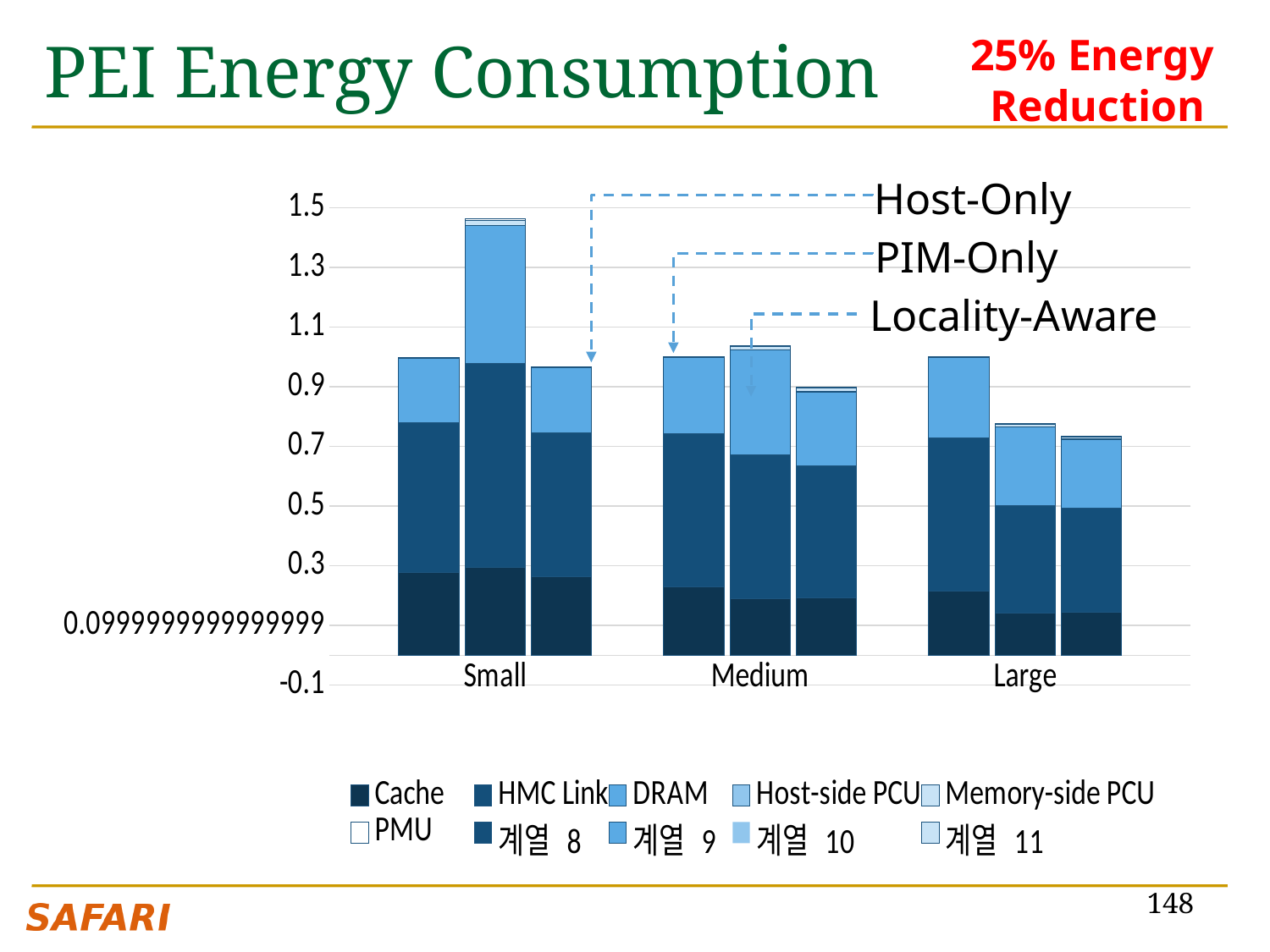
Is the PIM-Only bar for Small greater or less than 1.3? greater Is the PIM-Only bar for Large greater or less than 0.9? less Is the Locality-Aware bar for Large greater or less than 0.9? less What kind of chart is shown on the slide? stacked bar chart For Small, which bar is taller: PIM-Only or Locality-Aware? PIM-Only Do the Locality-Aware bars rise or fall from Small to Large? fall Which bar is the tallest in the chart? PIM-Only for Small For Medium, which bar is taller: PIM-Only or Locality-Aware? PIM-Only What is the title of the chart? PEI Energy Consumption How many entries does the legend list? 10 How many workload size categories are shown on the x axis? 3 What energy reduction is highlighted in red at the top right of the slide? 25% Energy Reduction